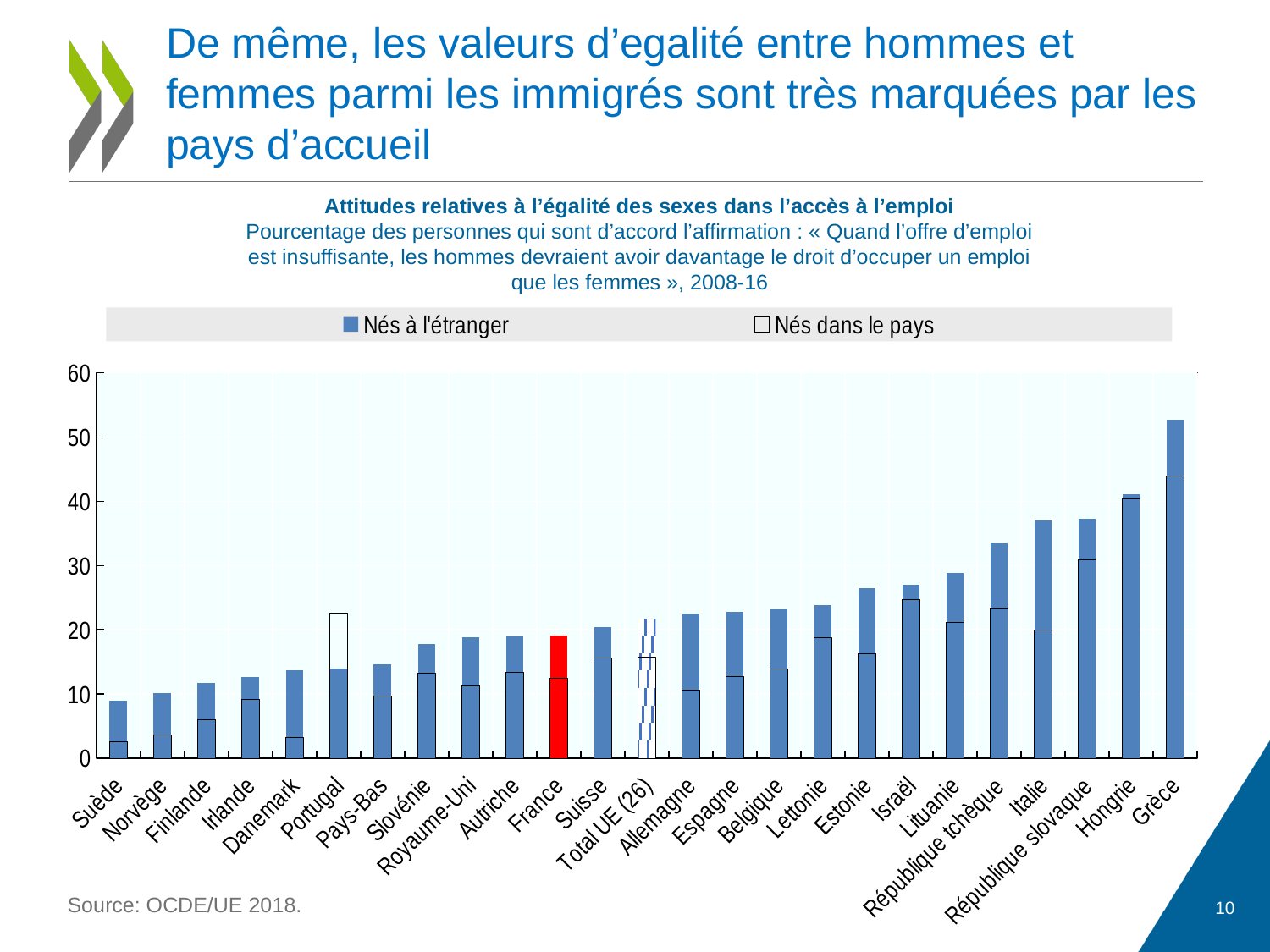
How many countries or groups are shown along the x axis of the chart? 25 What kind of chart is shown on the slide? bar chart Which country has the lowest value for 'Nés à l'étranger'? Suède Is the 'Nés dans le pays' value for Portugal greater or less than 20? greater Is the 'Nés à l'étranger' value for Suède greater or less than 10? less How many series does the chart legend list? 2 Which country has the highest value for 'Nés à l'étranger'? Grèce Which country's bar is highlighted in red on the chart? France For Portugal, which is larger: the value for 'Nés à l'étranger' or for 'Nés dans le pays'? Nés dans le pays Is the 'Nés à l'étranger' value for Grèce greater or less than 50? greater Do the 'Nés à l'étranger' values generally rise or fall from left to right along the x axis? rise